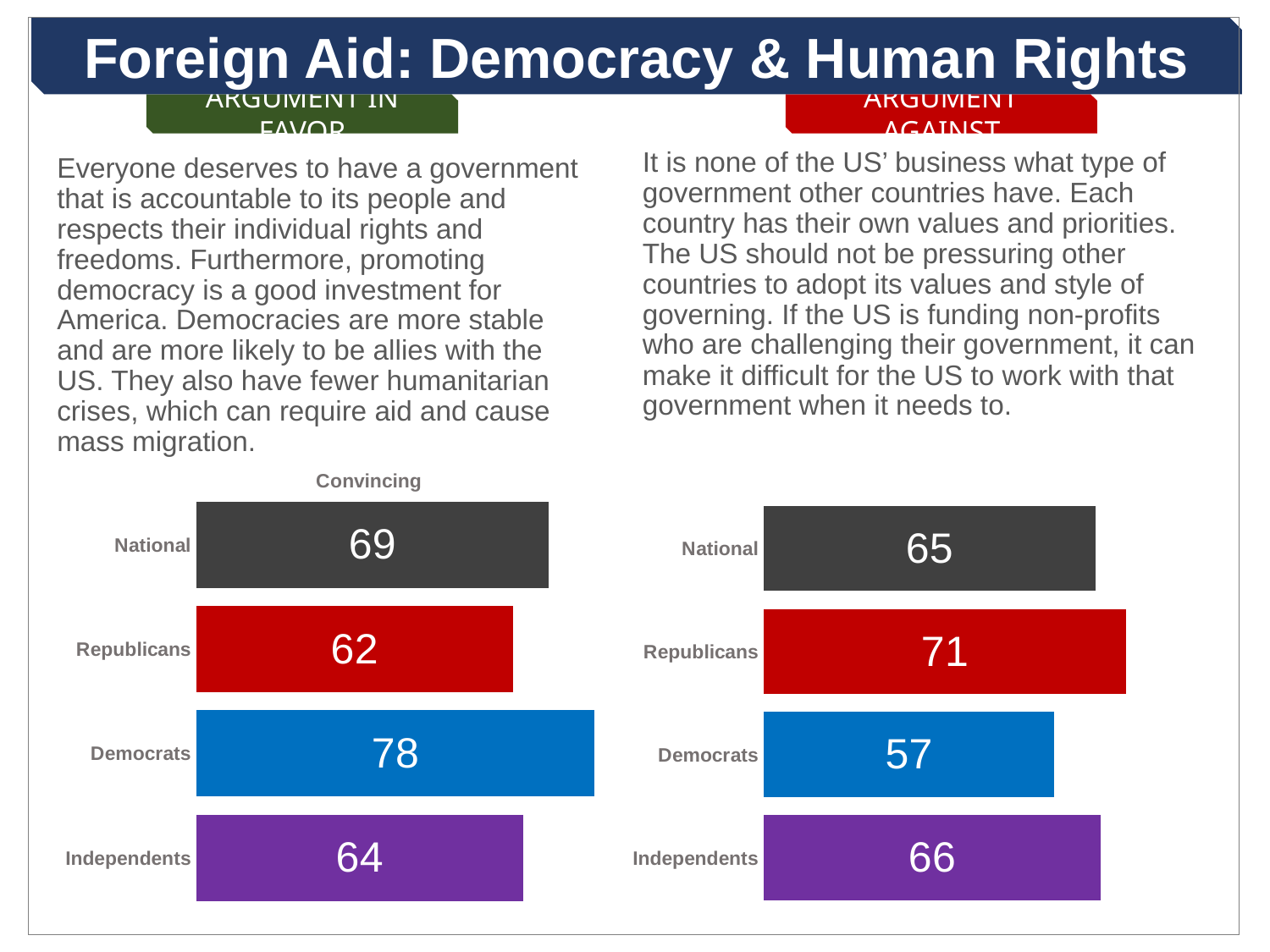
On the right chart, what is the value for Independents? 66 What kind of chart is the right chart? Bar chart On the right chart, what is the difference between the values for Republicans and Democrats? 14 On the right chart, which category has the lowest value? Democrats On the right chart, which is larger, the value for National or the value for Republicans? Republicans On the left chart, what is the value for Democrats? 78 On the left chart, what is the value for National? 69 On the right chart, what is the value for Republicans? 71 How many categories does the left chart show? 4 On the left chart, which category has the lowest value? Republicans On the left chart, what is the difference between the values for Democrats and Independents? 14 On the left chart, which category has the highest value? Democrats